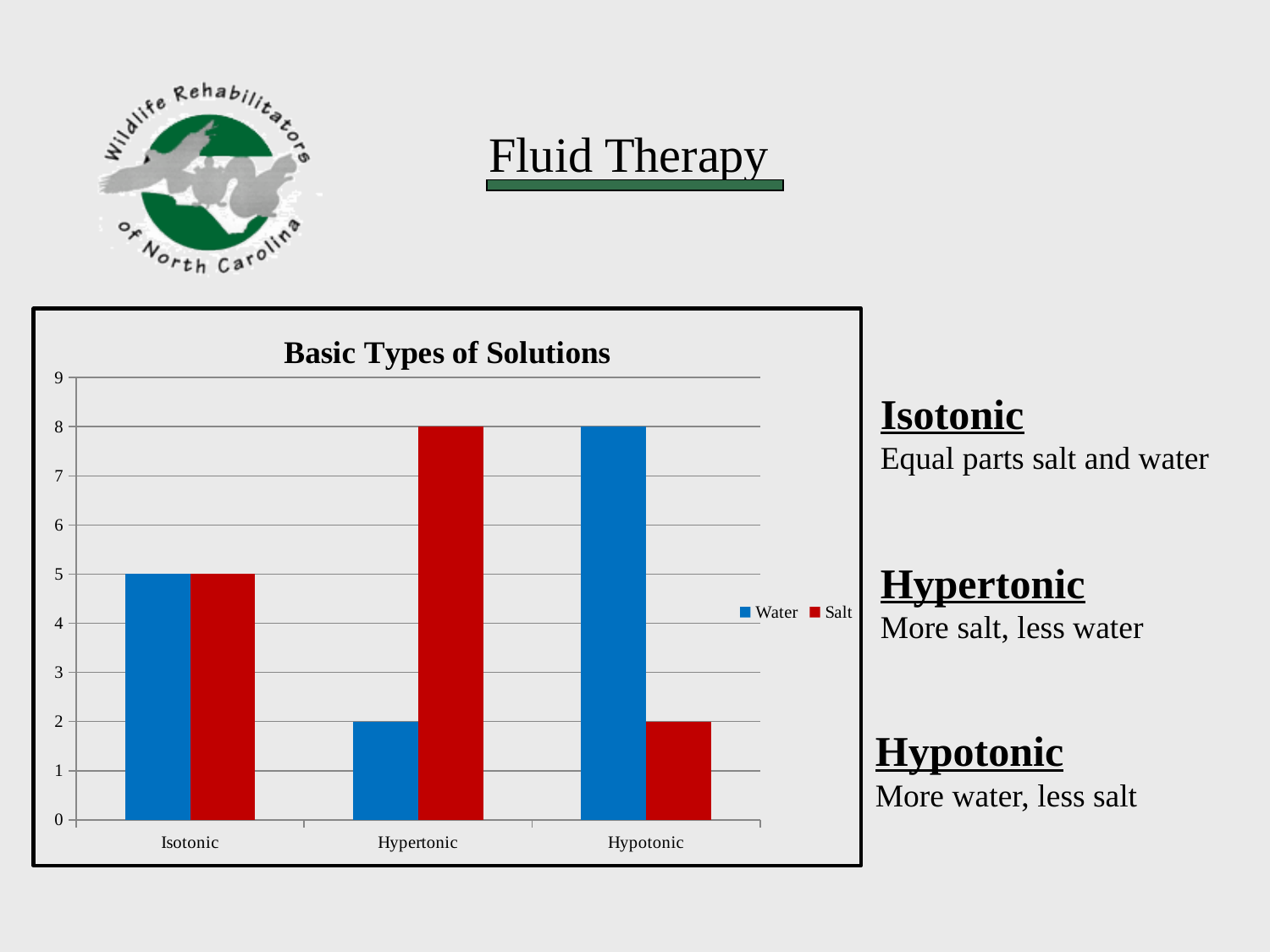
Which series in the "Basic Types of Solutions" chart is shown in red? Salt What is the Water value for Isotonic in the "Basic Types of Solutions" chart? 5 What is the Salt value for Hypotonic in the "Basic Types of Solutions" chart? 2 How many series does the legend of the "Basic Types of Solutions" chart list? 2 What type of chart is shown under the title "Basic Types of Solutions"? bar chart What is the Salt value for Hypertonic in the "Basic Types of Solutions" chart? 8 In the "Basic Types of Solutions" chart, what is the difference between the Salt value and the Water value for Hypertonic? 6 Which category has the lowest Water value in the "Basic Types of Solutions" chart? Hypertonic Which category has the highest Salt value in the "Basic Types of Solutions" chart? Hypertonic How many categories are shown on the x axis of the "Basic Types of Solutions" chart? 3 What is the Water value for Hypotonic in the "Basic Types of Solutions" chart? 8 In the "Basic Types of Solutions" chart, is the Water value or the Salt value larger for Hypotonic? Water